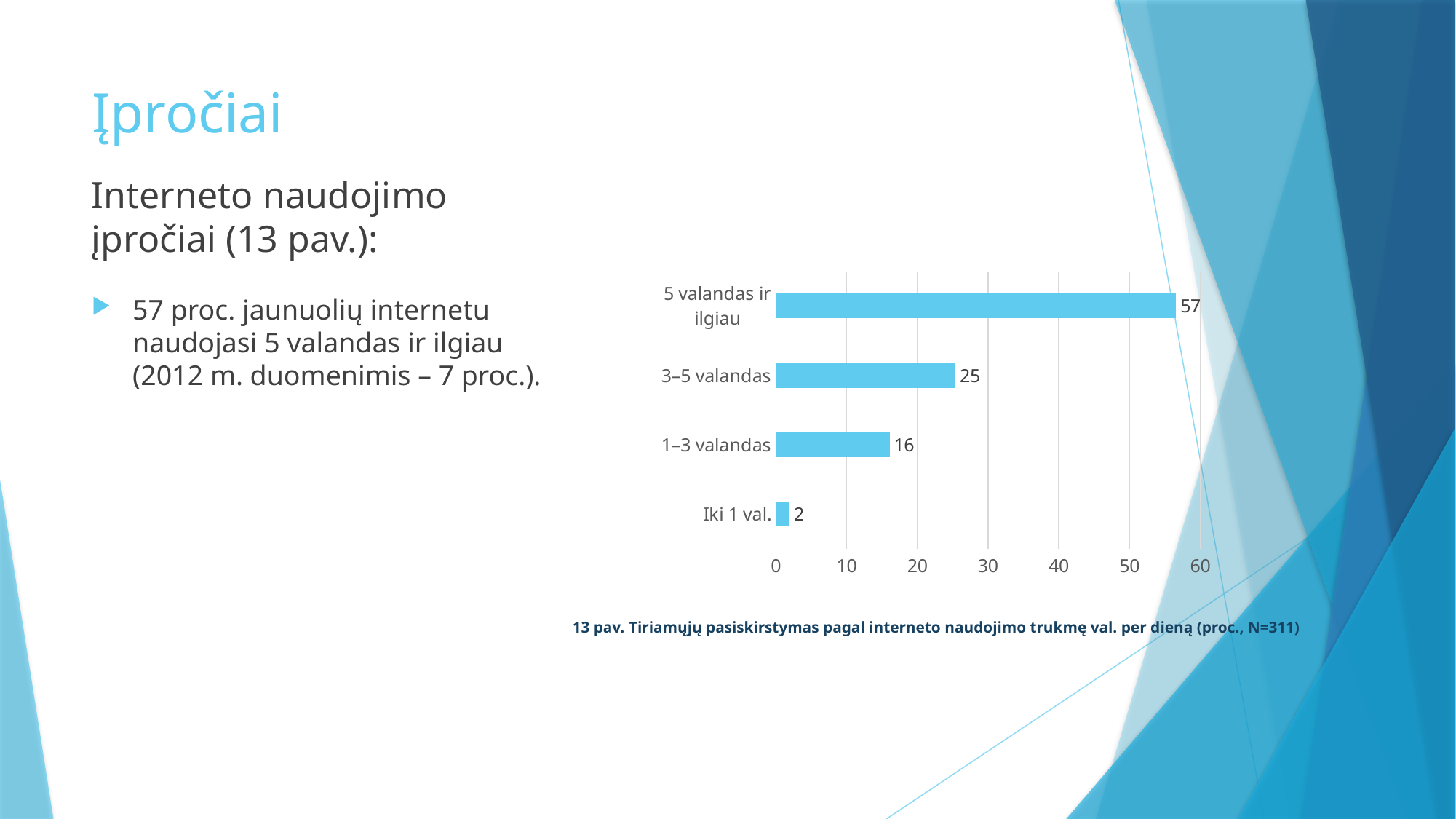
What is the value for "Iki 1 val."? 2 Which category has the lowest value? Iki 1 val. Which is larger, the value for "3–5 valandas" or the value for "1–3 valandas"? 3–5 valandas What kind of chart is shown on the slide? bar chart Is the value for "5 valandas ir ilgiau" greater or less than 50? greater What is the difference between the values for "1–3 valandas" and "Iki 1 val."? 14 What is the value for "5 valandas ir ilgiau"? 57 What is the value for "1–3 valandas"? 16 Which category has the highest value? 5 valandas ir ilgiau What is the value for "3–5 valandas"? 25 How many categories are shown in the chart? 4 What is the difference between the values for "5 valandas ir ilgiau" and "3–5 valandas"? 32